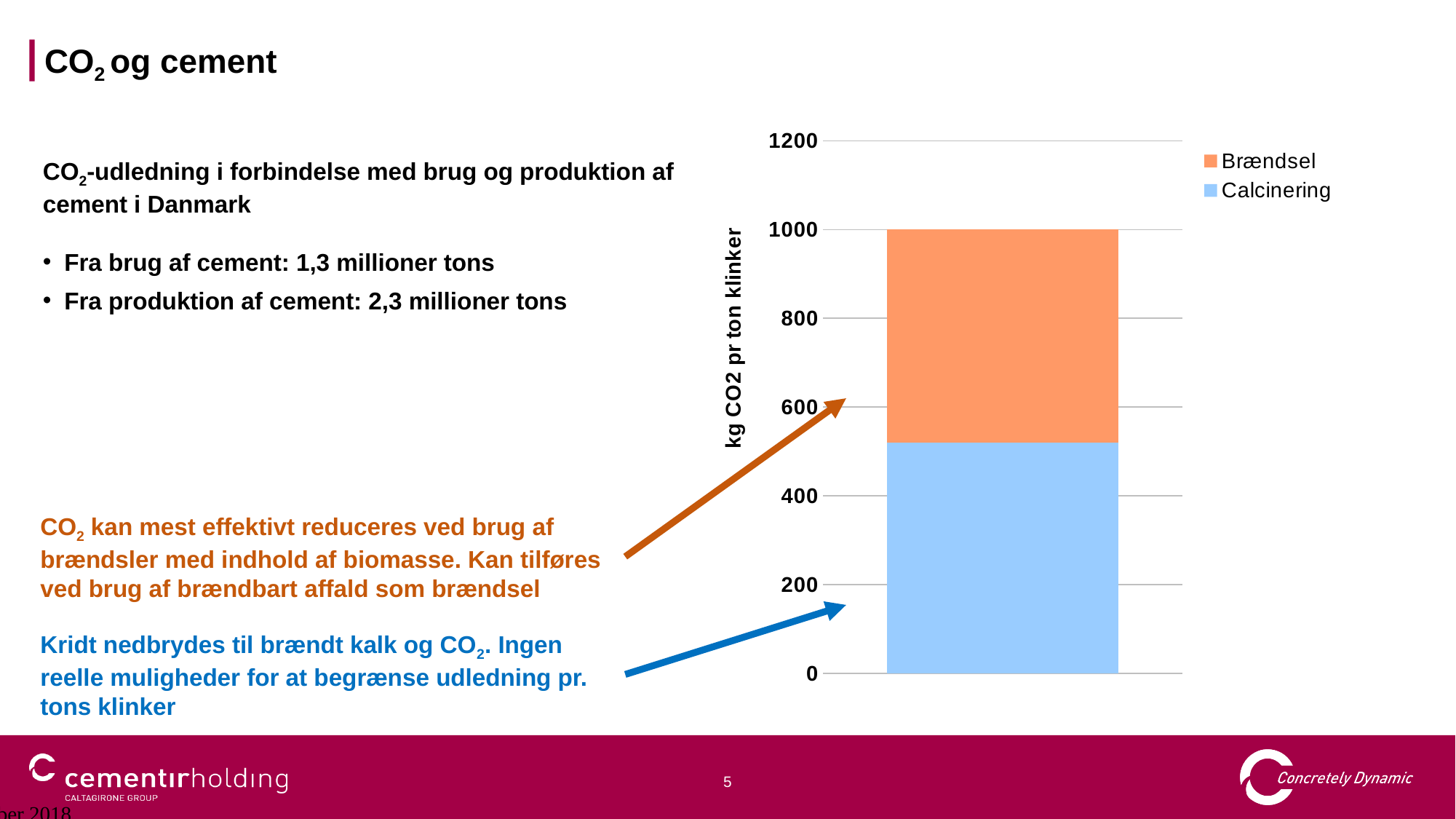
How many series does the chart legend list? 2 Which series are listed in the chart legend? Brændsel and Calcinering Is the value of the Calcinering segment greater or less than 600? less What kind of chart is shown on the slide? stacked bar chart What is the total height of the stacked bar in kg CO2 pr ton klinker? 1000 What is the title of the vertical axis of the chart? kg CO2 pr ton klinker Is the value of the Calcinering segment greater or less than 400? greater Is the value of the Brændsel segment greater or less than 400? greater What is the highest value shown on the vertical axis of the chart? 1200 How many bars are plotted in the chart? 1